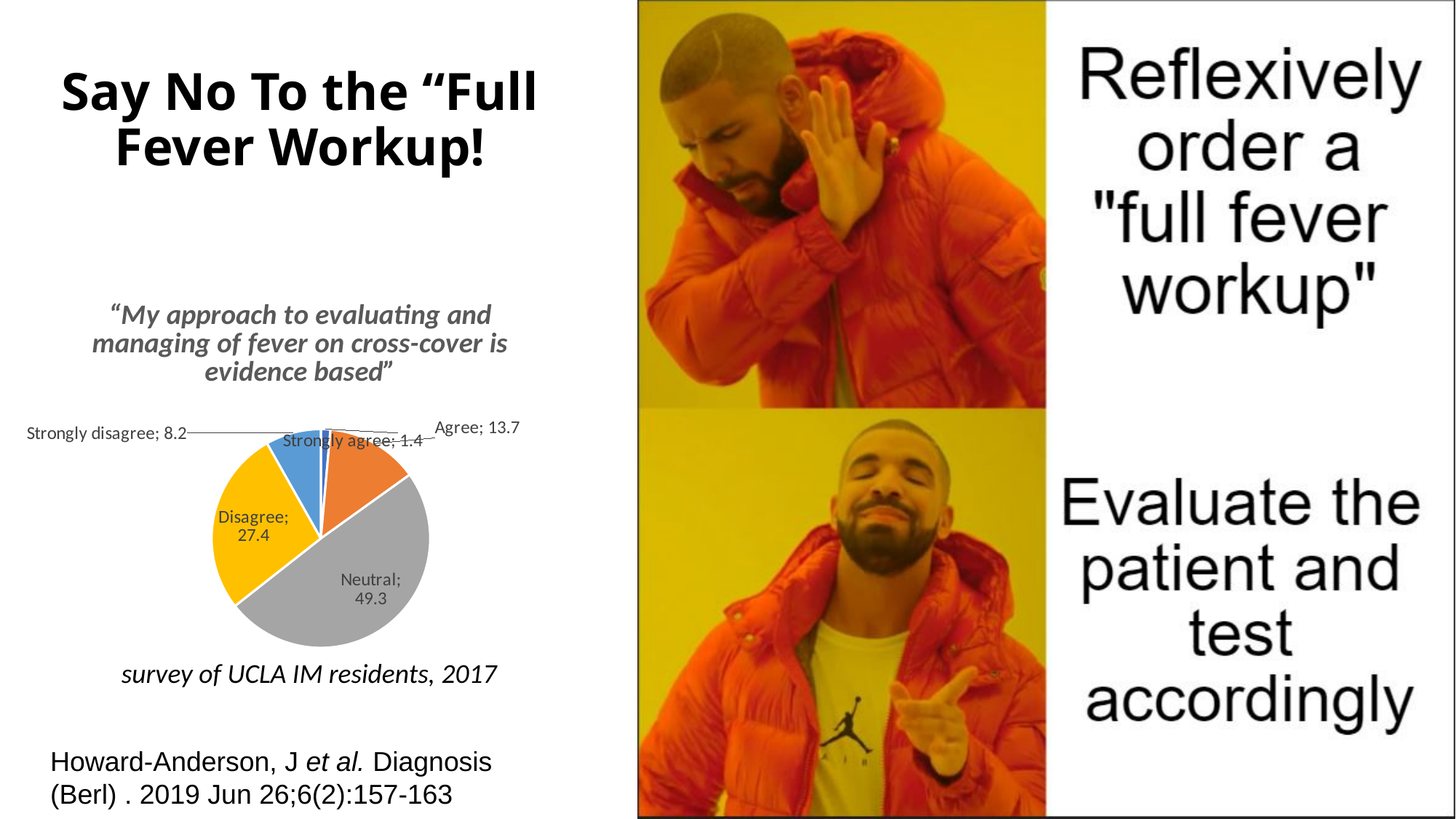
Which category has the smallest slice in the pie chart? Strongly agree Which is larger in the pie chart, Agree or Strongly disagree? Agree What value is shown for the Agree slice of the pie chart? 13.7 What value is shown for the Neutral slice of the pie chart? 49.3 According to the caption below the pie chart, who was surveyed and in what year? UCLA IM residents, 2017 Which category has the largest slice in the pie chart? Neutral How many categories does the pie chart show? 5 What value is shown for the Strongly agree slice of the pie chart? 1.4 What value is shown for the Disagree slice of the pie chart? 27.4 What is the combined value of the Agree and Strongly agree slices in the pie chart? 15.1 What type of chart is shown on the slide? Pie chart What is the difference between the Neutral and Disagree values in the pie chart? 21.9